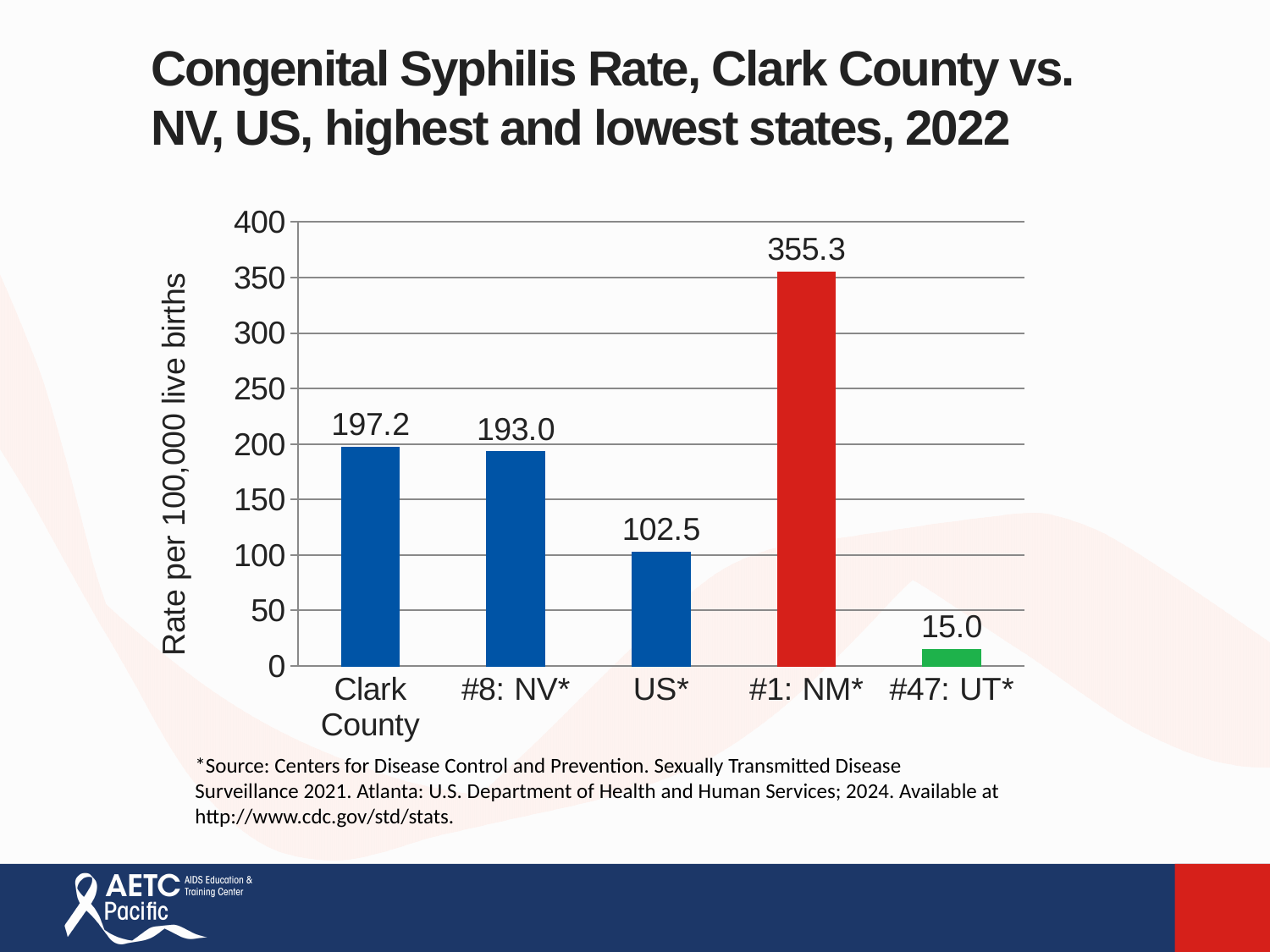
What is the value shown for US*? 102.5 Which is larger, the rate for US* or the rate for #8: NV*? #8: NV* What is the difference between the rates for Clark County and #8: NV*? 4.2 How many categories are shown on the x axis? 5 Which category has the highest rate? #1: NM* Which category has the lowest rate? #47: UT* What is the congenital syphilis rate for Clark County? 197.2 What is the label of the y axis? Rate per 100,000 live births What is the value shown for #1: NM*? 355.3 What is the difference between the rates for #1: NM* and US*? 252.8 What is the value shown for #47: UT*? 15.0 What kind of chart is shown on the slide? Bar chart